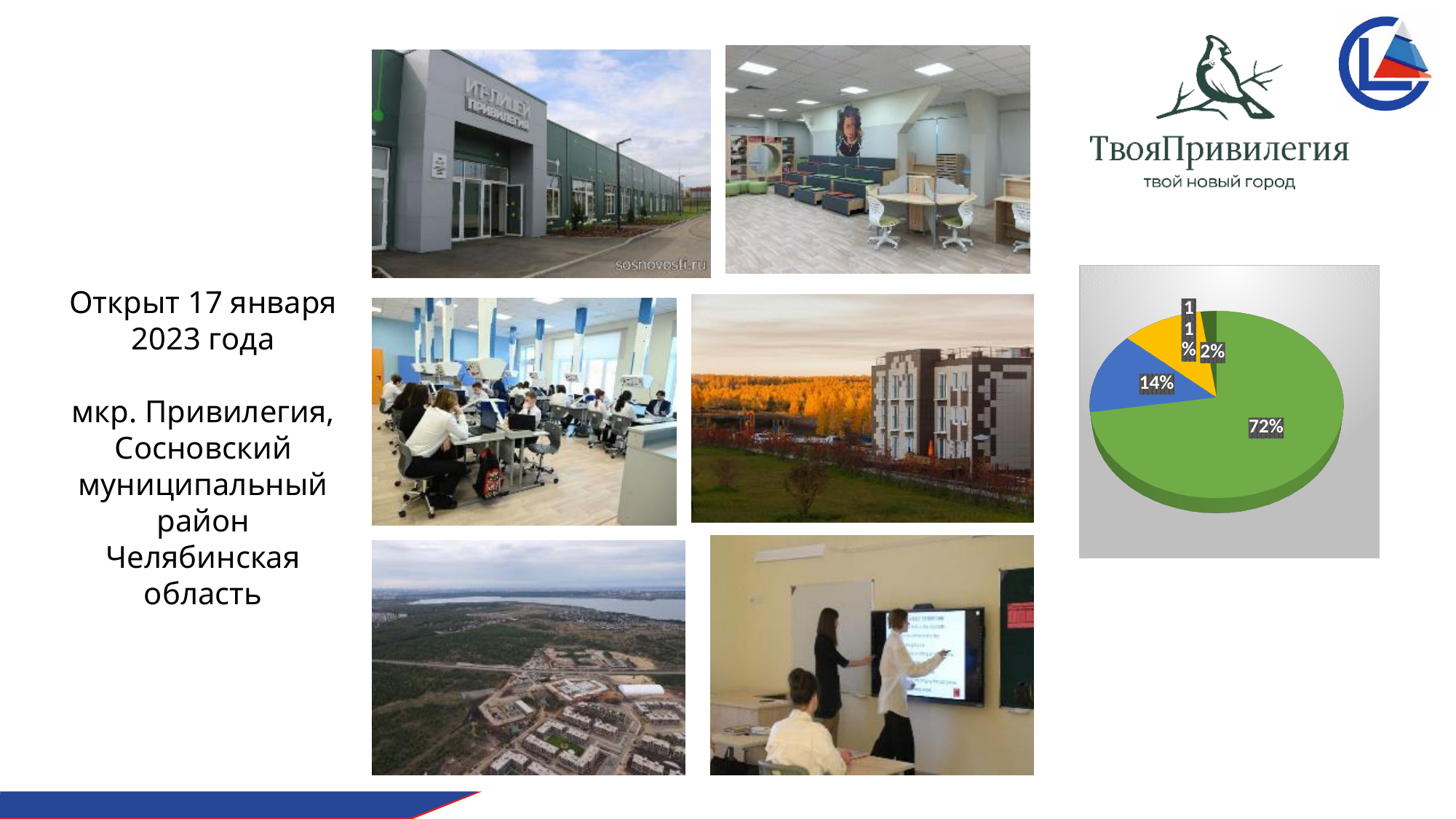
In the pie chart, which slice is larger, the green one or the blue one? green Which colour is the largest slice of the pie chart? green In the pie chart, what percentage is labelled on the green slice? 72% In the pie chart, what percentage is labelled on the yellow slice? 11% In the pie chart, what is the difference between the blue slice (14%) and the yellow slice (11%)? 3% Is the green slice of the pie chart greater or less than 50% of the pie? greater In the pie chart, what is the difference between the green slice (72%) and the blue slice (14%)? 58% What kind of chart is shown on the right side of the slide? pie chart In the pie chart, what percentage is labelled on the blue slice? 14% In the pie chart, what percentage is labelled on the dark grey slice? 2% What is the value of the largest slice in the pie chart? 72%